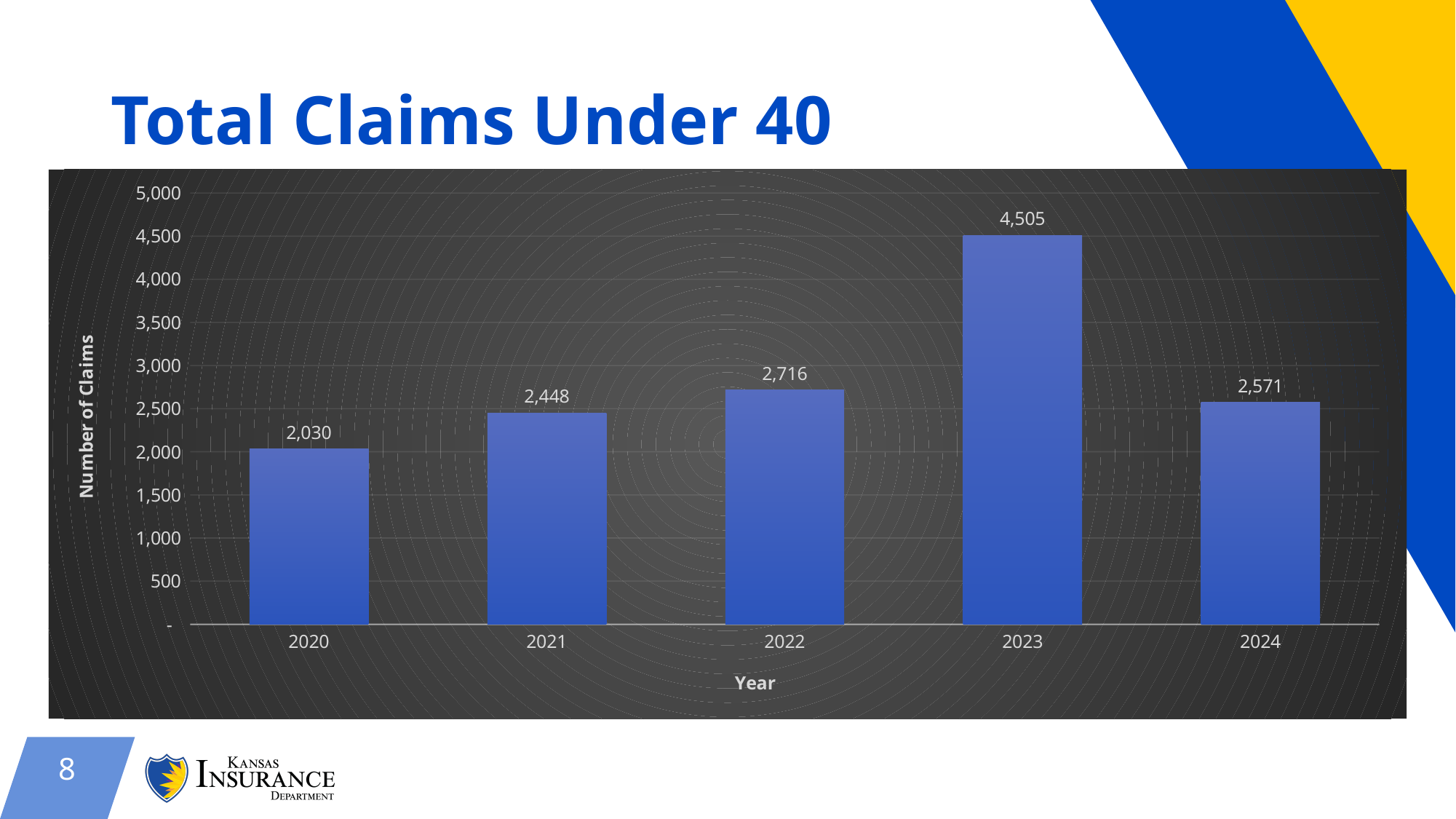
What kind of chart is shown on the slide? Bar chart Which year has the lowest number of claims? 2020 How many years are shown on the x axis? 5 What is the number of claims for 2020? 2,030 Which year has more claims, 2022 or 2024? 2022 What is the difference in claims between 2021 and 2020? 418 Which year has the highest number of claims? 2023 What is the title of the chart? Total Claims Under 40 Is the value for 2023 greater or less than 4,000? greater What is the number of claims for 2023? 4,505 What is the difference in claims between 2023 and 2022? 1,789 What is the number of claims for 2024? 2,571